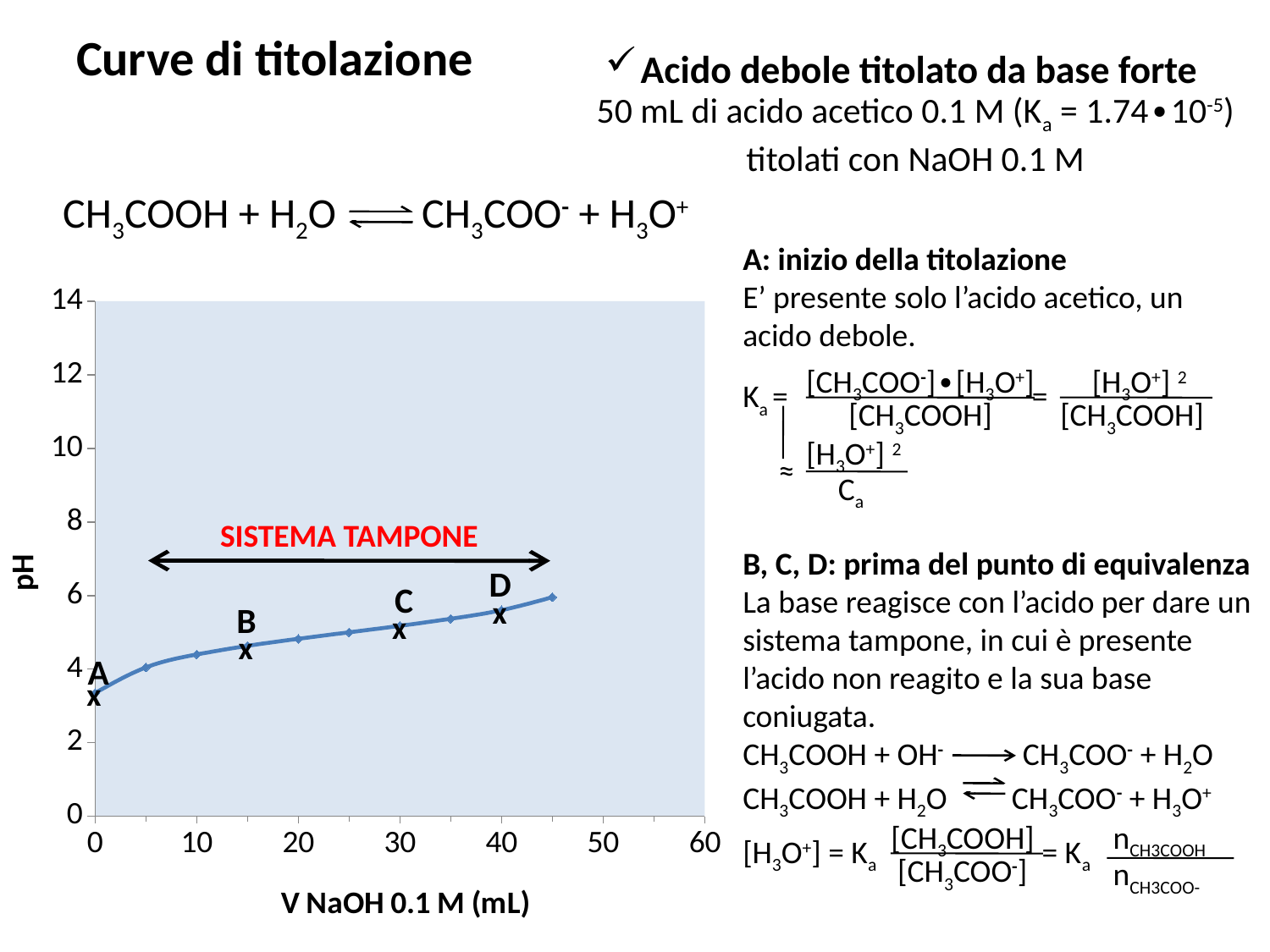
Which point has the higher pH, B or D? D What kind of chart is shown on the slide? line chart How many data points are plotted on the curve? 10 At which volume of NaOH is the plotted pH highest? 45 Does the pH rise or fall as the volume of NaOH increases along the x axis? rises What is the title of the x axis of the chart? V NaOH 0.1 M (mL) Is the pH at point B (15 mL NaOH) greater or less than 4? greater Is the pH at point A (0 mL NaOH) greater or less than 4? less Which point has the lower pH, A or C? A At which volume of NaOH is the plotted pH lowest? 0 Is the pH at point D (40 mL NaOH) greater or less than 6? less What is the title of the y axis of the chart? pH